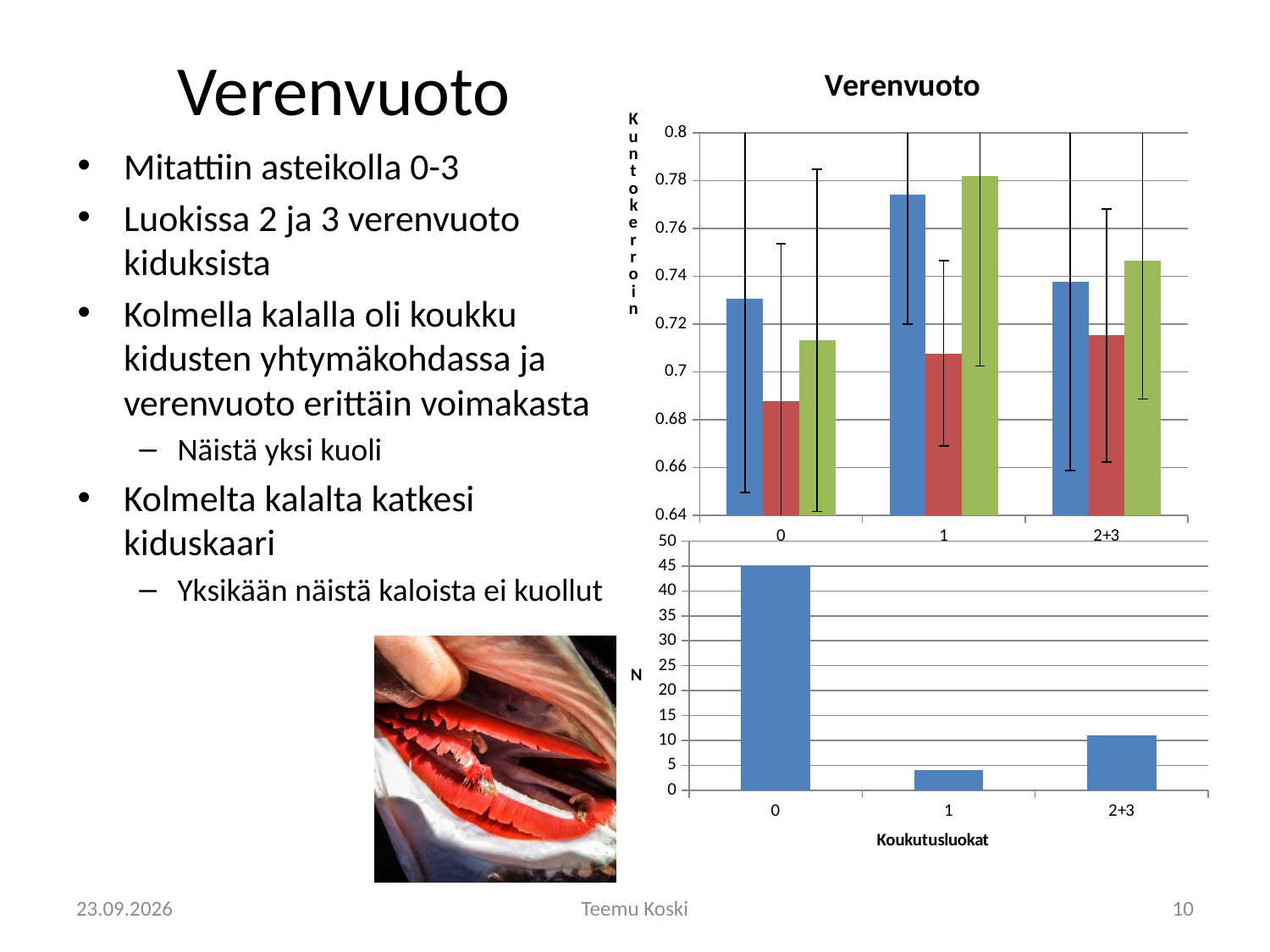
In the bottom chart (N vs Koukutusluokat), what is the value of N for category 0? 45 In the top chart titled Verenvuoto, is the blue bar for category 0 greater or less than 0.72? greater What is the label of the x axis of the bottom chart? Koukutusluokat In the top chart titled Verenvuoto, is the red bar for category 0 greater or less than 0.7? less In the bottom chart (N vs Koukutusluokat), which category has the lowest N? 1 In the bottom chart (N vs Koukutusluokat), is the value for category 2+3 greater or less than 10? greater In the top chart titled Verenvuoto, for which category is the blue bar highest? 1 What kind of chart is the bottom chart (N vs Koukutusluokat)? bar chart In the bottom chart (N vs Koukutusluokat), which is larger: N for category 2+3 or N for category 1? 2+3 How many categories are shown on the x axis of the top chart titled Verenvuoto? 3 In the bottom chart (N vs Koukutusluokat), which category has the highest N? 0